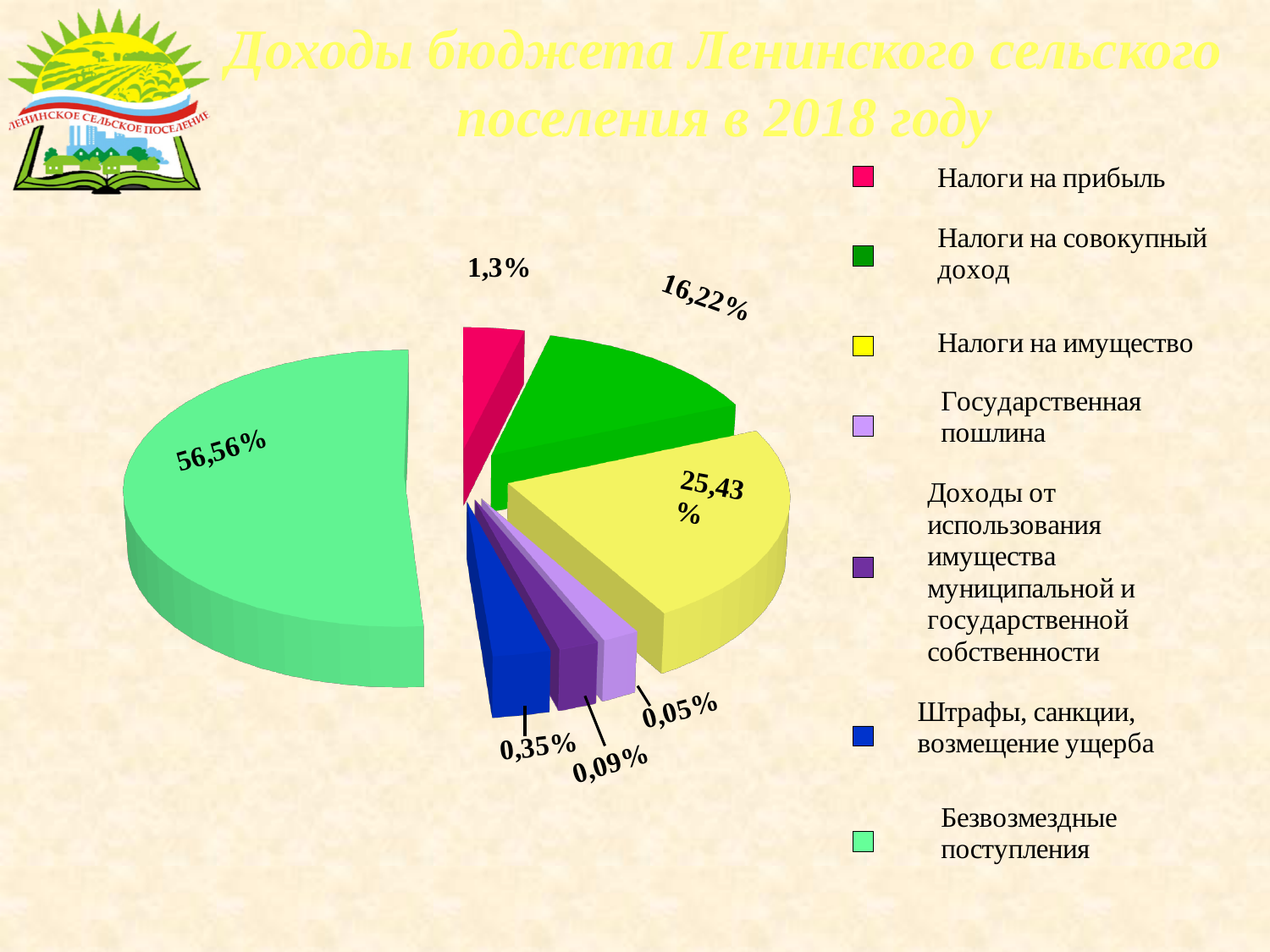
What is the value shown for Налоги на прибыль? 1,3% Which category has the largest slice of the pie? Безвозмездные поступления What is the value shown for Налоги на совокупный доход? 16,22% What is the difference between the values for Налоги на имущество and Налоги на совокупный доход? 9,21% What is the value shown for Штрафы, санкции, возмещение ущерба? 0,35% Which category has the smallest slice of the pie? Государственная пошлина What share of the pie does Безвозмездные поступления have? 56,56% How many categories does the legend list? 7 What kind of chart is shown on the slide? pie chart What is the value shown for Государственная пошлина? 0,05% Which is larger, Налоги на имущество or Налоги на совокупный доход? Налоги на имущество What is the value shown for Налоги на имущество? 25,43%